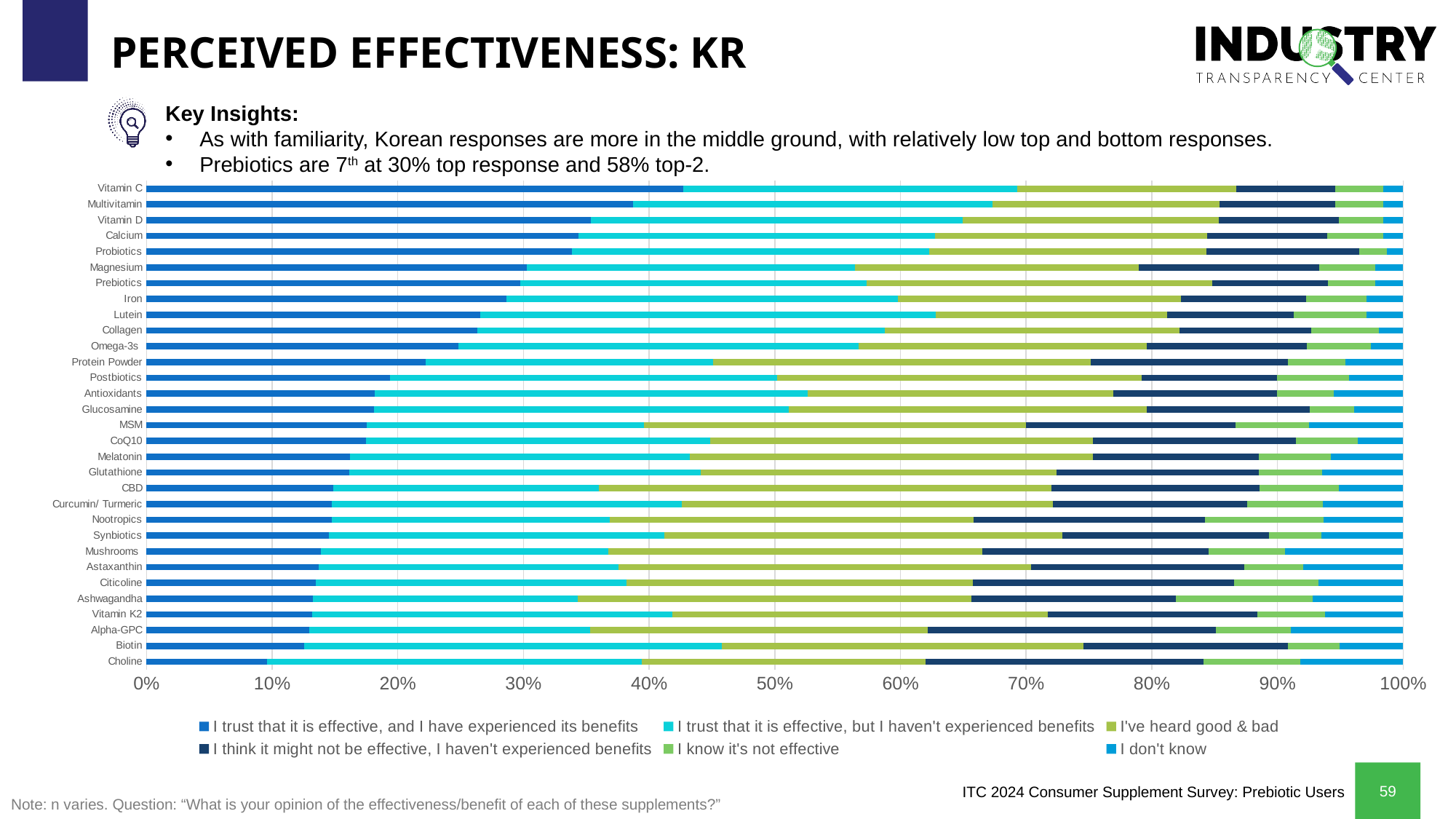
Is the 'I trust that it is effective, and I have experienced its benefits' value for Vitamin C greater or less than 40%? greater Is the 'I trust that it is effective, and I have experienced its benefits' value for Biotin greater or less than 20%? less Which supplement is listed at the top of the chart? Vitamin C Which supplement has the smallest 'I trust that it is effective, and I have experienced its benefits' segment? Choline How many supplement categories are plotted on the chart? 31 Which has a larger 'I trust that it is effective, and I have experienced its benefits' segment, Vitamin C or Choline? Vitamin C Which supplement has the largest 'I trust that it is effective, and I have experienced its benefits' segment? Vitamin C What is the title of the slide containing the chart? PERCEIVED EFFECTIVENESS: KR Is the 'I trust that it is effective, and I have experienced its benefits' value for Vitamin D greater or less than 30%? greater What kind of chart is shown on the slide? Stacked bar chart How many series does the legend list? 6